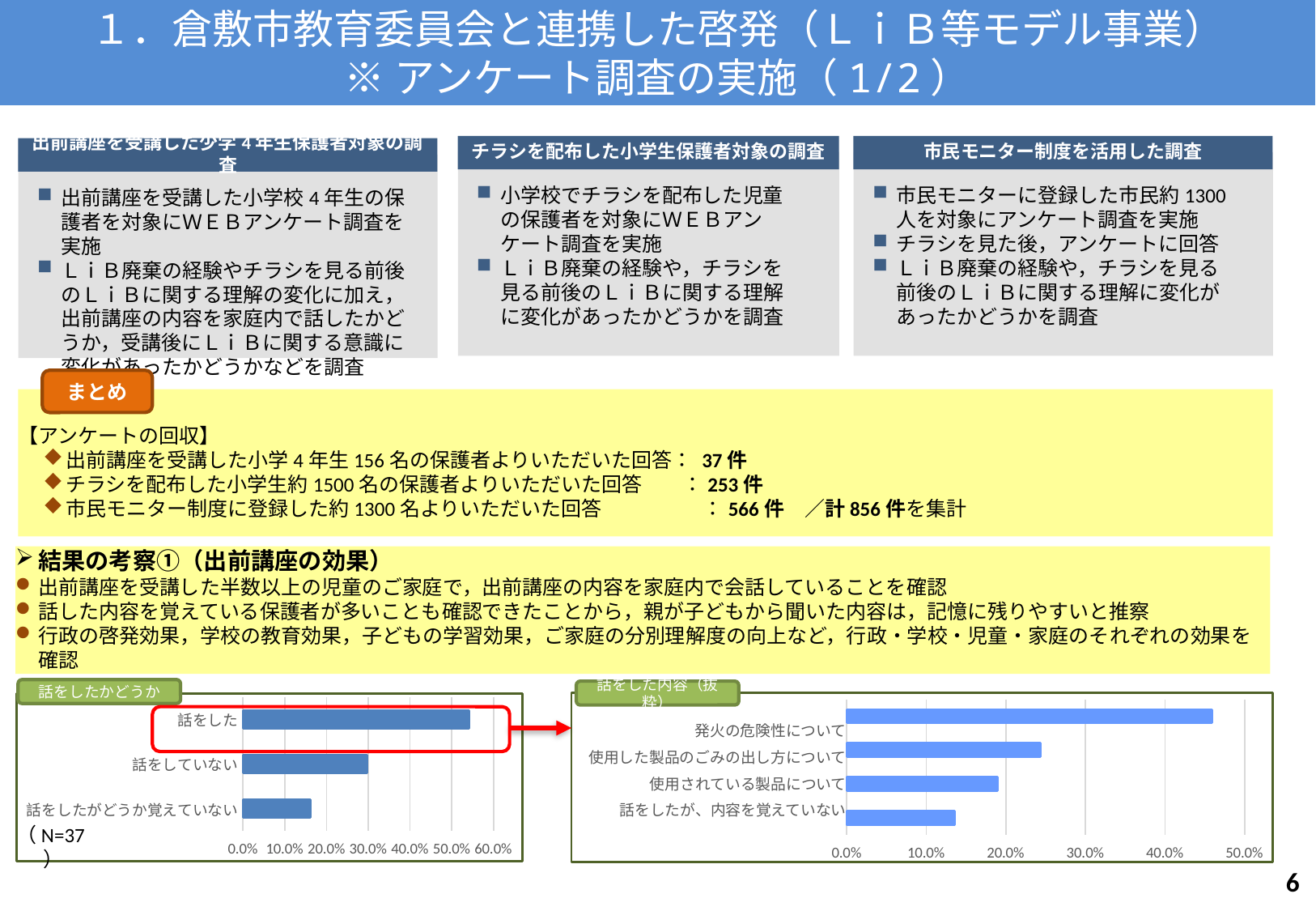
In the left chart titled 話をしたかどうか, which category has the lowest value? 話をしたがどうか覚えていない In the right chart titled 話をした内容（抜粋）, is the value for 発火の危険性について greater or less than 40.0%? greater In the left chart titled 話をしたかどうか, how many categories are plotted? 3 In the left chart titled 話をしたかどうか, is the value for 話をした greater or less than 50.0%? greater In the left chart titled 話をしたかどうか, is the value for 話をしたがどうか覚えていない greater or less than 20.0%? less In the right chart titled 話をした内容（抜粋）, which is larger: 使用した製品のごみの出し方について or 使用されている製品について? 使用した製品のごみの出し方について In the right chart titled 話をした内容（抜粋）, which category has the lowest value? 話をしたが、内容を覚えていない What is the sample size (N) shown for the left chart titled 話をしたかどうか? N=37 In the right chart titled 話をした内容（抜粋）, how many categories are plotted? 4 In the right chart titled 話をした内容（抜粋）, which category has the highest value? 発火の危険性について What kind of chart is the left chart titled 話をしたかどうか? bar chart In the left chart titled 話をしたかどうか, which category has the highest value? 話をした